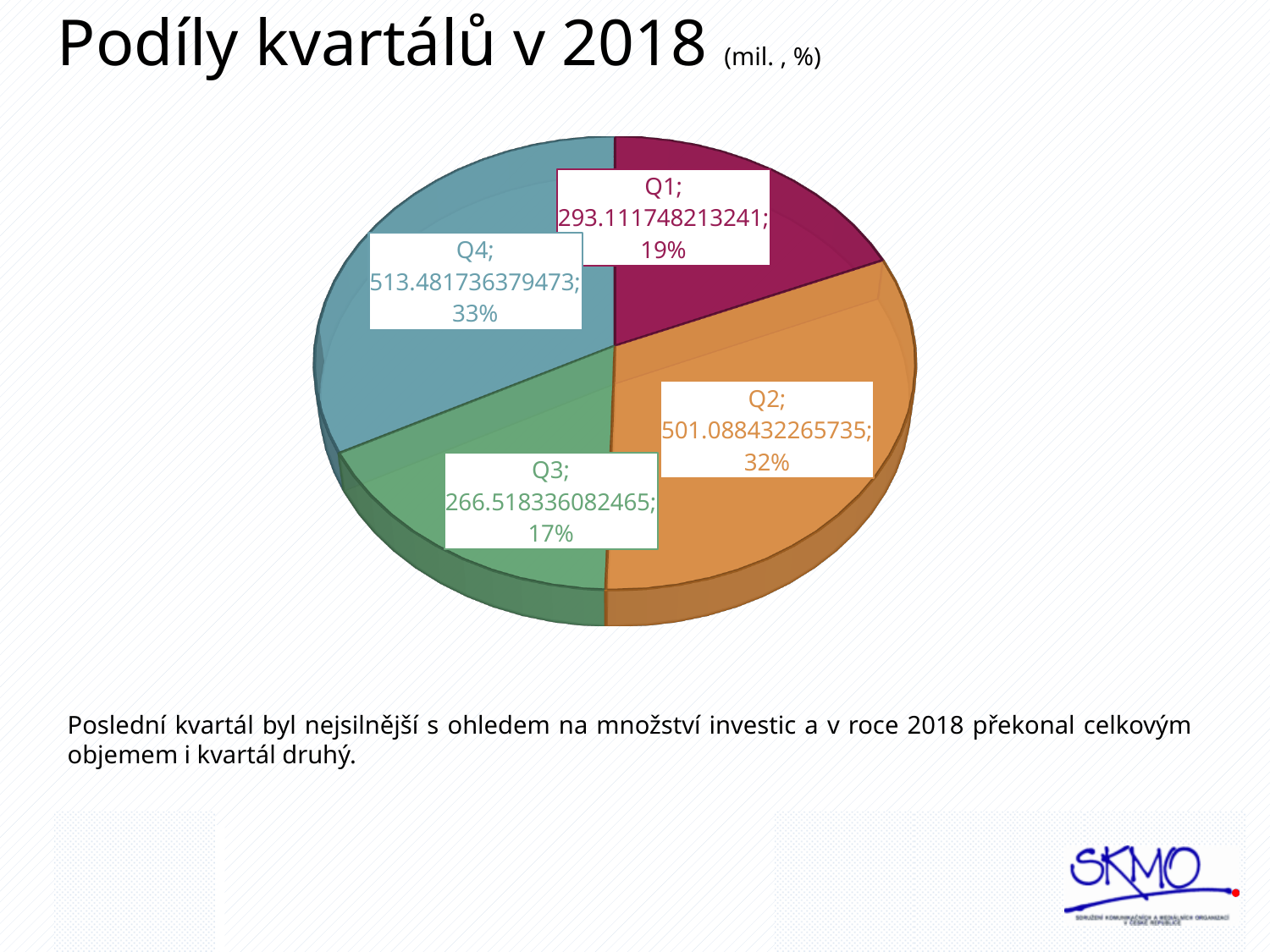
What share of the pie does Q4 represent? 33% What is the value shown for Q4? 513.481736379473 What is the value shown for Q3? 266.518336082465 Which quarter has the largest slice of the pie? Q4 Which quarter has the smallest slice of the pie? Q3 What is the value shown for Q1? 293.111748213241 What share of the pie does Q3 represent? 17% How many slices does the pie chart have? 4 Which is larger, the value for Q1 or the value for Q3? Q1 What kind of chart is shown on the slide? pie chart What is the value shown for Q2? 501.088432265735 What is the title of the chart? Podíly kvartálů v 2018